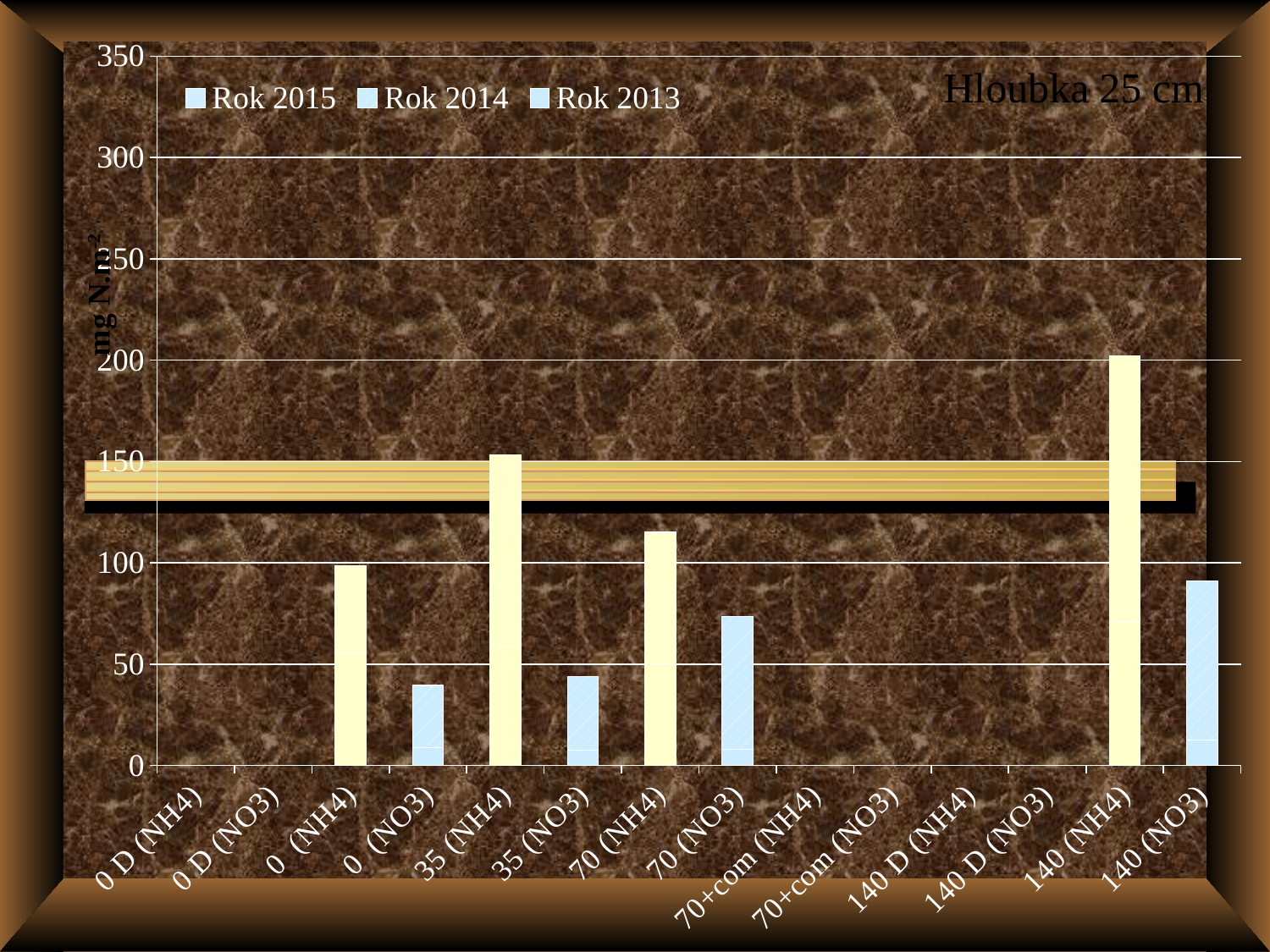
What is the title shown on the chart? Hloubka 25 cm Is the value for 140 (NO3) greater or less than 100? less Which category has the tallest bar? 140 (NH4) How many series does the legend list? 3 What is the label of the y axis? mg N.m² Is the value for 0 (NO3) greater or less than 50? less Which is larger, the value for 35 (NH4) or the value for 140 (NH4)? 140 (NH4) Is the value for 70 (NH4) greater or less than 100? greater What kind of chart is shown on the slide? bar chart How many categories are shown on the x axis? 14 Which is larger, the value for 70 (NH4) or the value for 70 (NO3)? 70 (NH4)